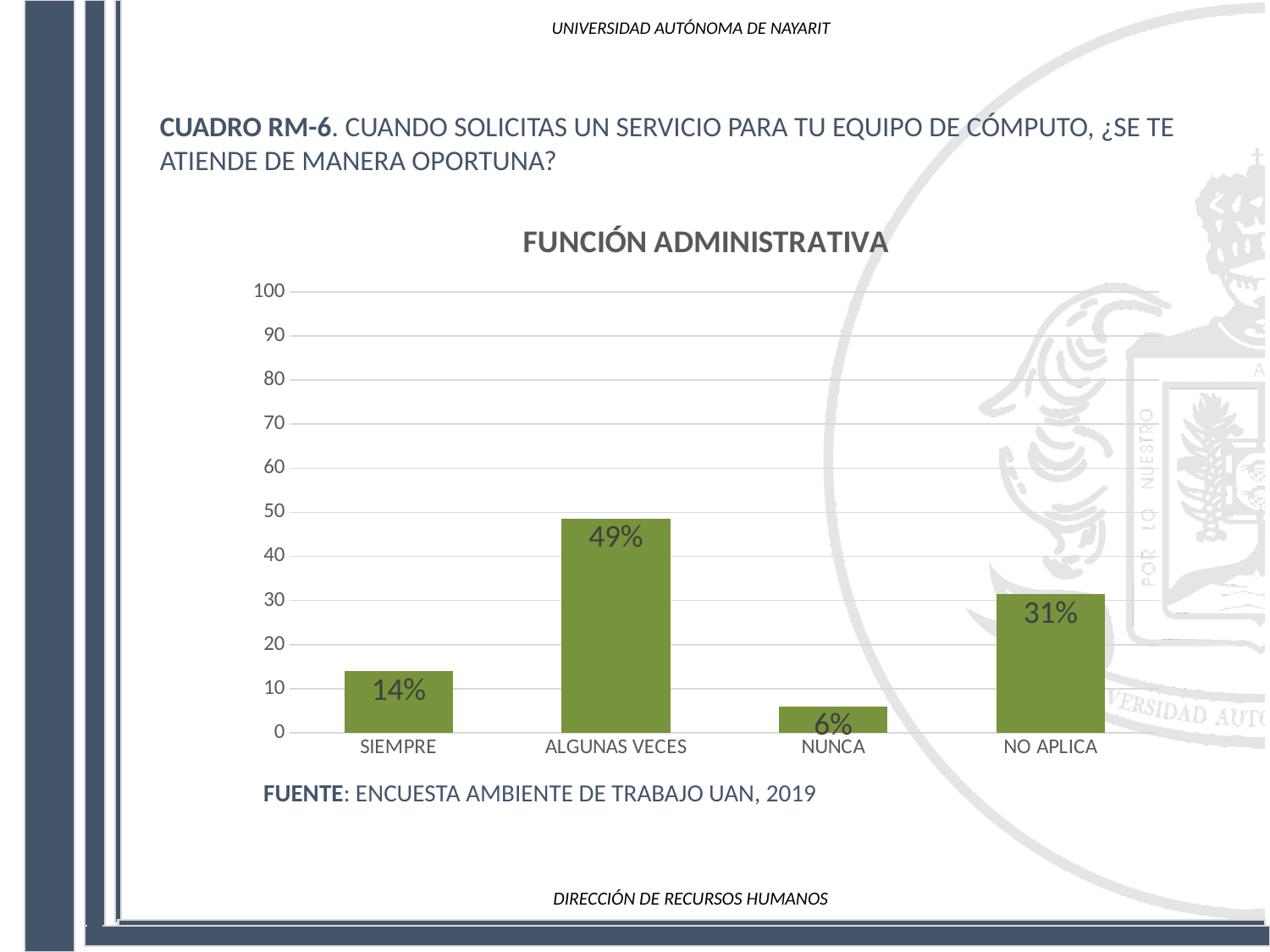
What is the value for NO APLICA? 31% How many categories are shown on the x axis? 4 What is the value for ALGUNAS VECES? 49% Which category has the highest value? ALGUNAS VECES What kind of chart is shown on the slide? bar chart Which is larger, the value for SIEMPRE or the value for NO APLICA? NO APLICA Which category has the lowest value? NUNCA What is the value for SIEMPRE? 14% Is the value for NO APLICA greater or less than 40? less What is the value for NUNCA? 6% What is the title of the chart? FUNCIÓN ADMINISTRATIVA What is the difference between the values for ALGUNAS VECES and NO APLICA? 18%